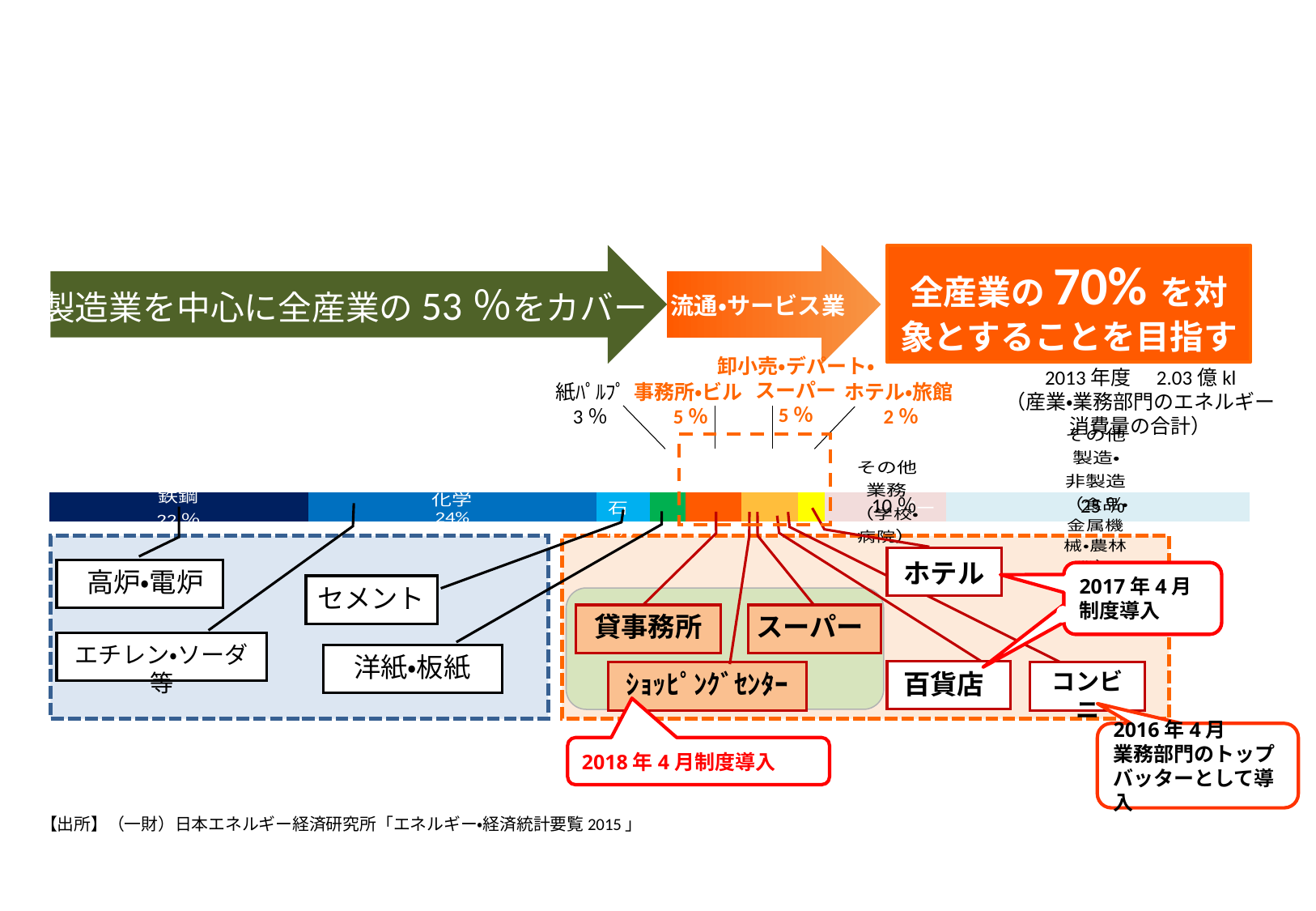
What share is shown for 事務所・ビル? 5% Which has the larger share, 鉄鋼 or 化学? 化学 What share is shown for 紙パルプ? 3% What share is shown for ホテル・旅館? 2% What total energy consumption for 2013年度 is stated above the bar? 2.03億kl By how many percentage points does 事務所・ビル exceed ホテル・旅館? 3 What kind of chart is shown on the slide? bar chart What share of all industries does the orange box say is the target to cover? 70% By how many percentage points does 化学 exceed 鉄鋼? 2 What share is shown for その他業務? 10% What share is shown for 鉄鋼 in the bar? 22% What share is shown for 化学 in the bar? 24%